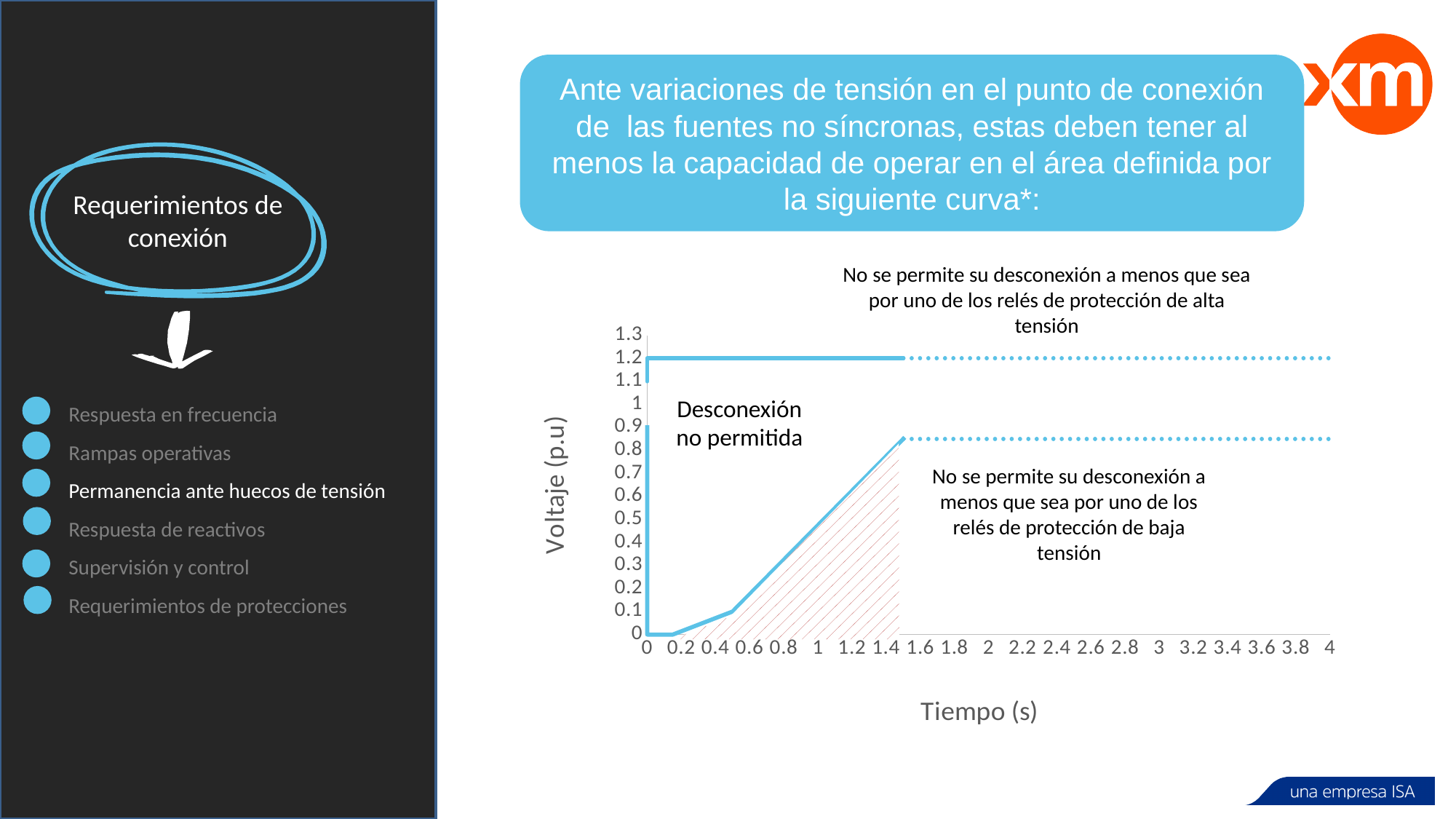
Is the value of the upper horizontal line greater or less than 1? greater What is the highest tick value shown on the y axis? 1.3 Does the lower curve rise or fall between 0 s and 1.4 s? rise What is the title of the y axis of the chart? Voltaje (p.u) What kind of chart is shown on the slide? line chart Which line is higher on the chart, the upper solid line or the lower dotted line? the upper solid line Is the value of the lower curve at 1 s greater or less than 0.3? greater Is the value of the lower curve at 0.4 s greater or less than 0.2? less What is the title of the x axis of the chart? Tiempo (s) At what voltage level (p.u) does the upper horizontal line of the curve sit? 1.2 What is the highest tick value shown on the x axis? 4